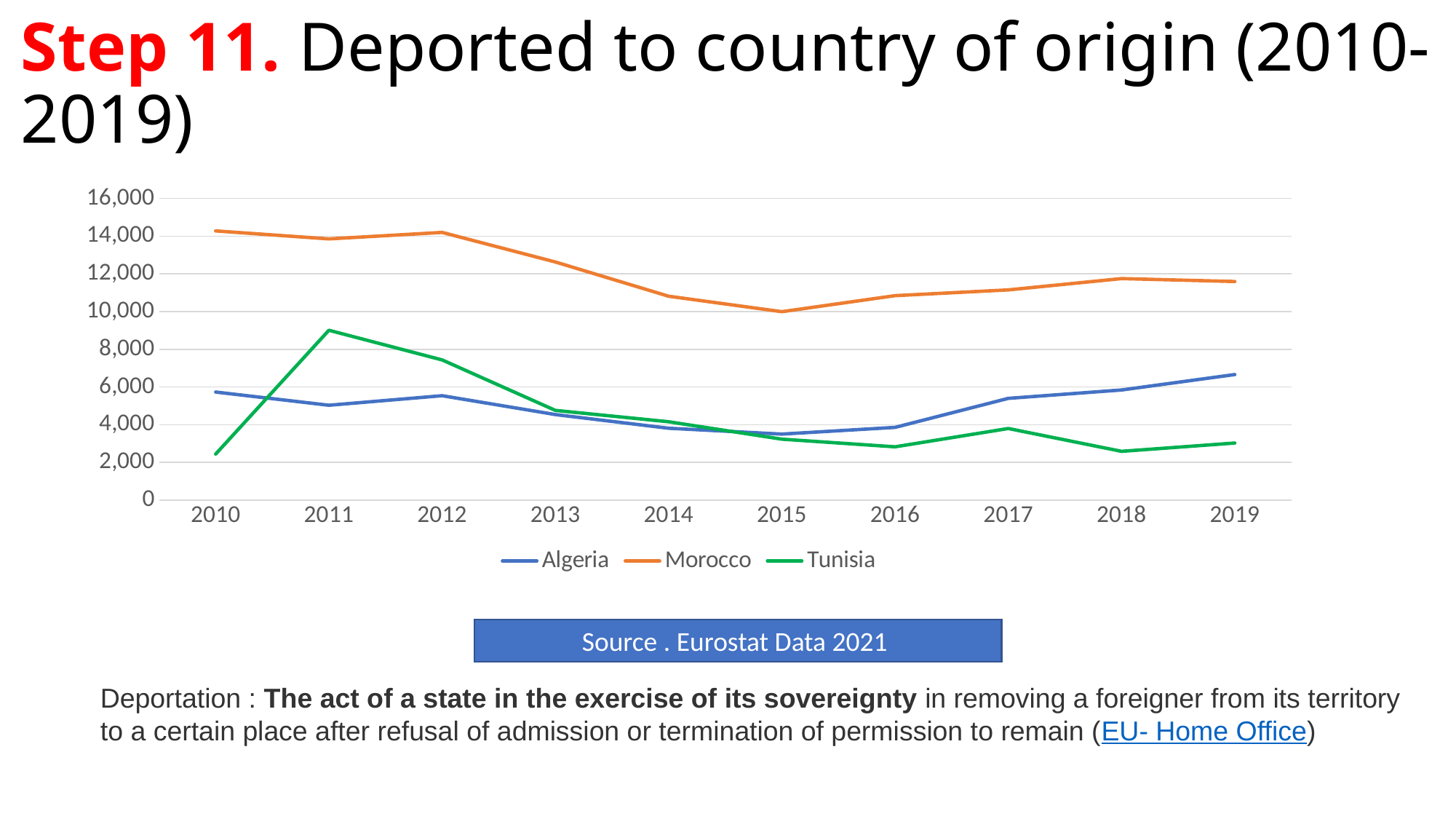
In which year does the Tunisia line reach its highest value? 2011 How many series does the legend list? 3 How many years are plotted along the x axis? 10 Is the value for Tunisia in 2010 greater or less than 4,000? less Which country has the highest number of deportations in every year shown? Morocco Is the value for Tunisia in 2011 greater or less than 8,000? greater Does the Morocco line rise or fall between 2012 and 2015? fall In which year does the Morocco line reach its lowest value? 2015 Is the value for Morocco in 2010 greater or less than 12,000? greater In 2011, which is larger: the value for Algeria or the value for Tunisia? Tunisia What kind of chart is shown on the slide? line chart In 2019, which is larger: the value for Algeria or the value for Tunisia? Algeria